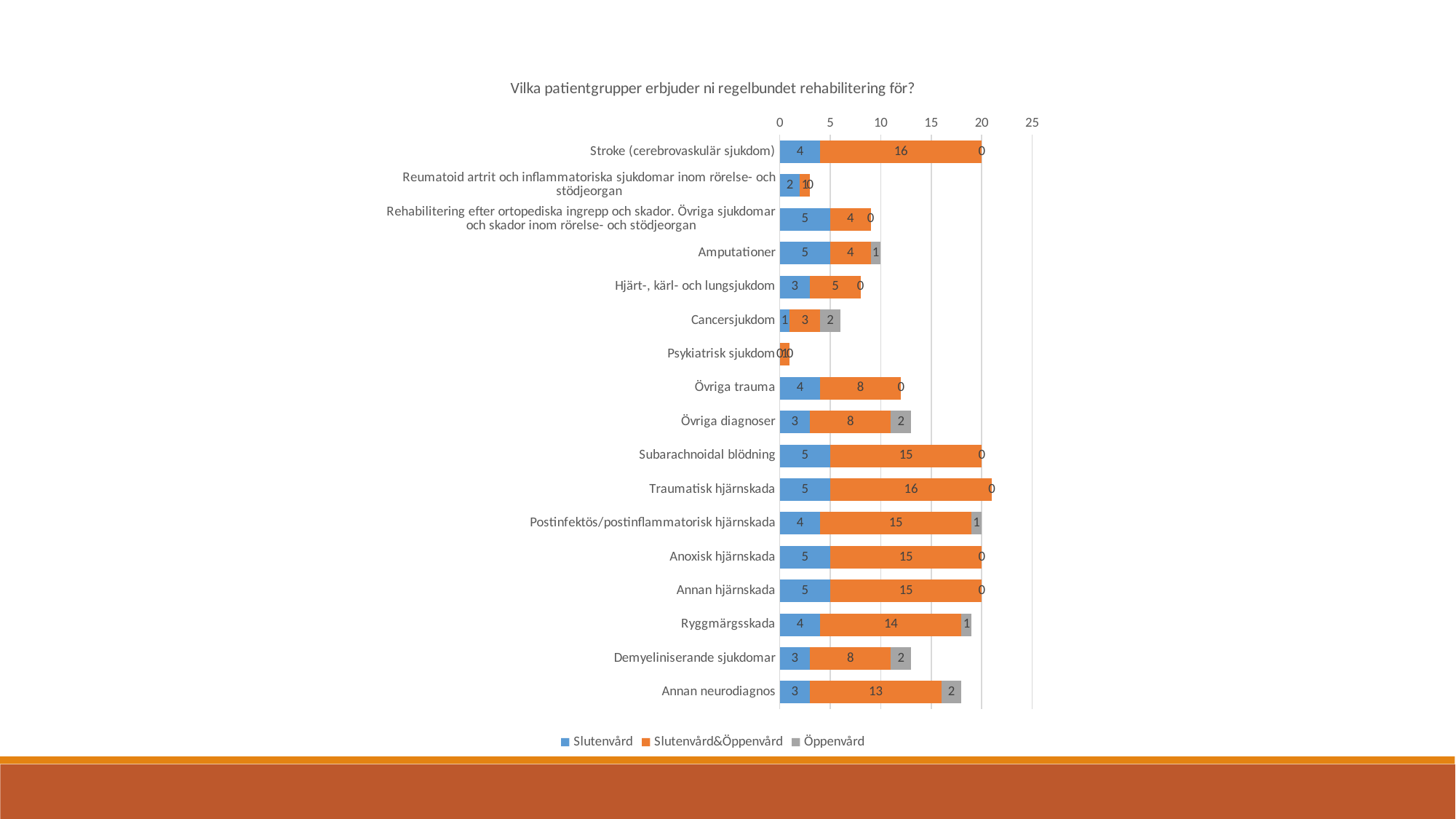
Which category has the lowest stacked bar total? Psykiatrisk sjukdom What is the total of the stacked bar for Demyeliniserande sjukdomar? 13 What is the Slutenvård&Öppenvård value for Stroke (cerebrovaskulär sjukdom)? 16 What is the total of the stacked bar for Traumatisk hjärnskada? 21 What kind of chart is shown on the slide? Stacked bar chart How many series does the legend list? 3 What is the difference between the Slutenvård&Öppenvård values for Ryggmärgsskada and Övriga trauma? 6 How many patient group categories are shown on the chart? 17 What is the Öppenvård value for Cancersjukdom? 2 What is the Slutenvård&Öppenvård value for Annan neurodiagnos? 13 Which is larger, the Slutenvård&Öppenvård value for Hjärt-, kärl- och lungsjukdom or for Övriga diagnoser? Övriga diagnoser What is the Slutenvård value for Amputationer? 5